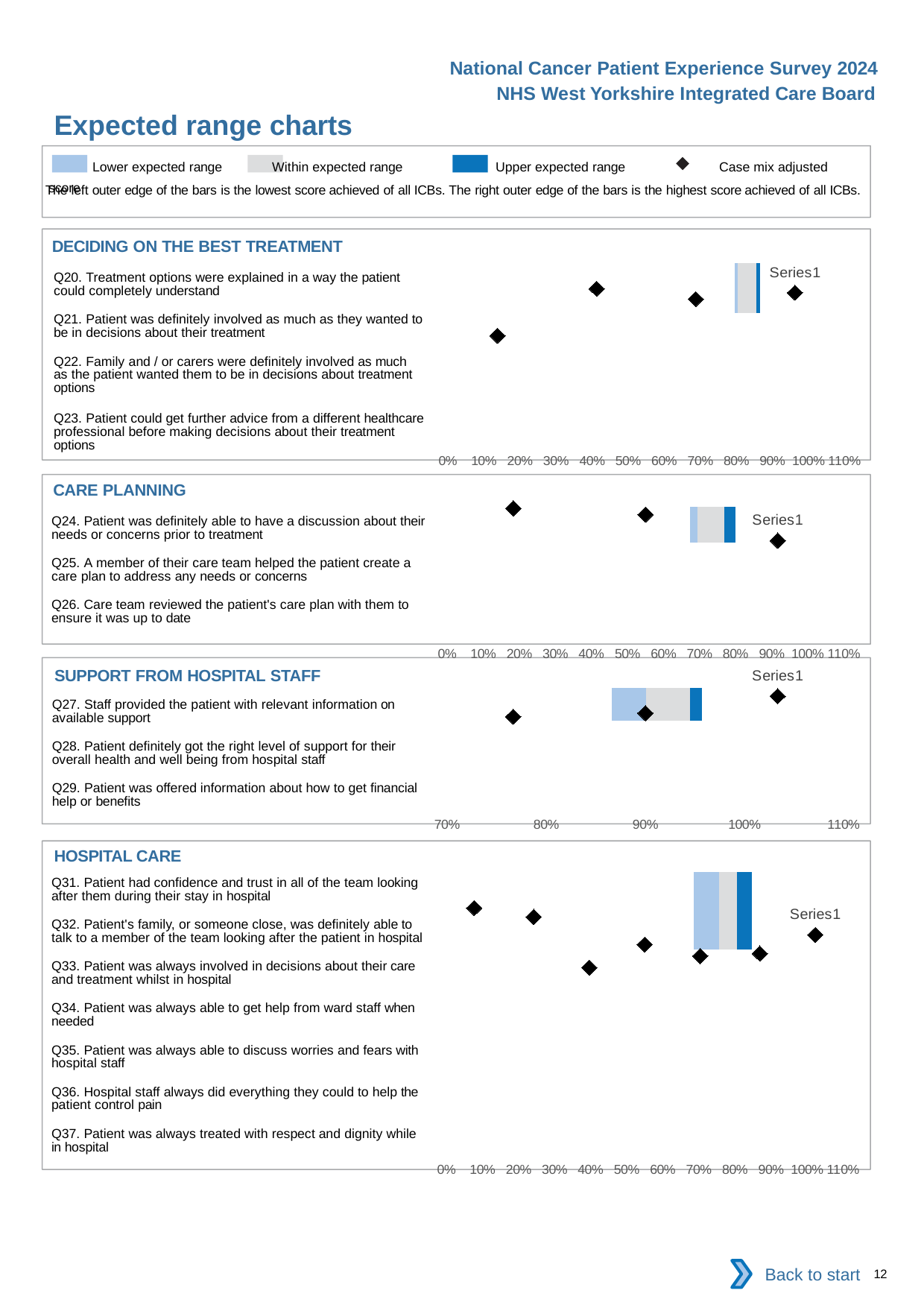
In the 'HOSPITAL CARE' chart, how many series does the legend list? 1 In the 'HOSPITAL CARE' chart, what is the highest value shown on the x axis? 110% In the 'SUPPORT FROM HOSPITAL STAFF' chart, what is the lowest value shown on the x axis? 70% In the 'DECIDING ON THE BEST TREATMENT' chart, how many question categories are listed? 4 What kind of chart is the 'DECIDING ON THE BEST TREATMENT' chart? bar chart In the 'SUPPORT FROM HOSPITAL STAFF' chart, how many question categories are listed? 3 In the 'CARE PLANNING' chart, what is the name of the series shown in the legend? Series1 How many charts are shown on the slide? 4